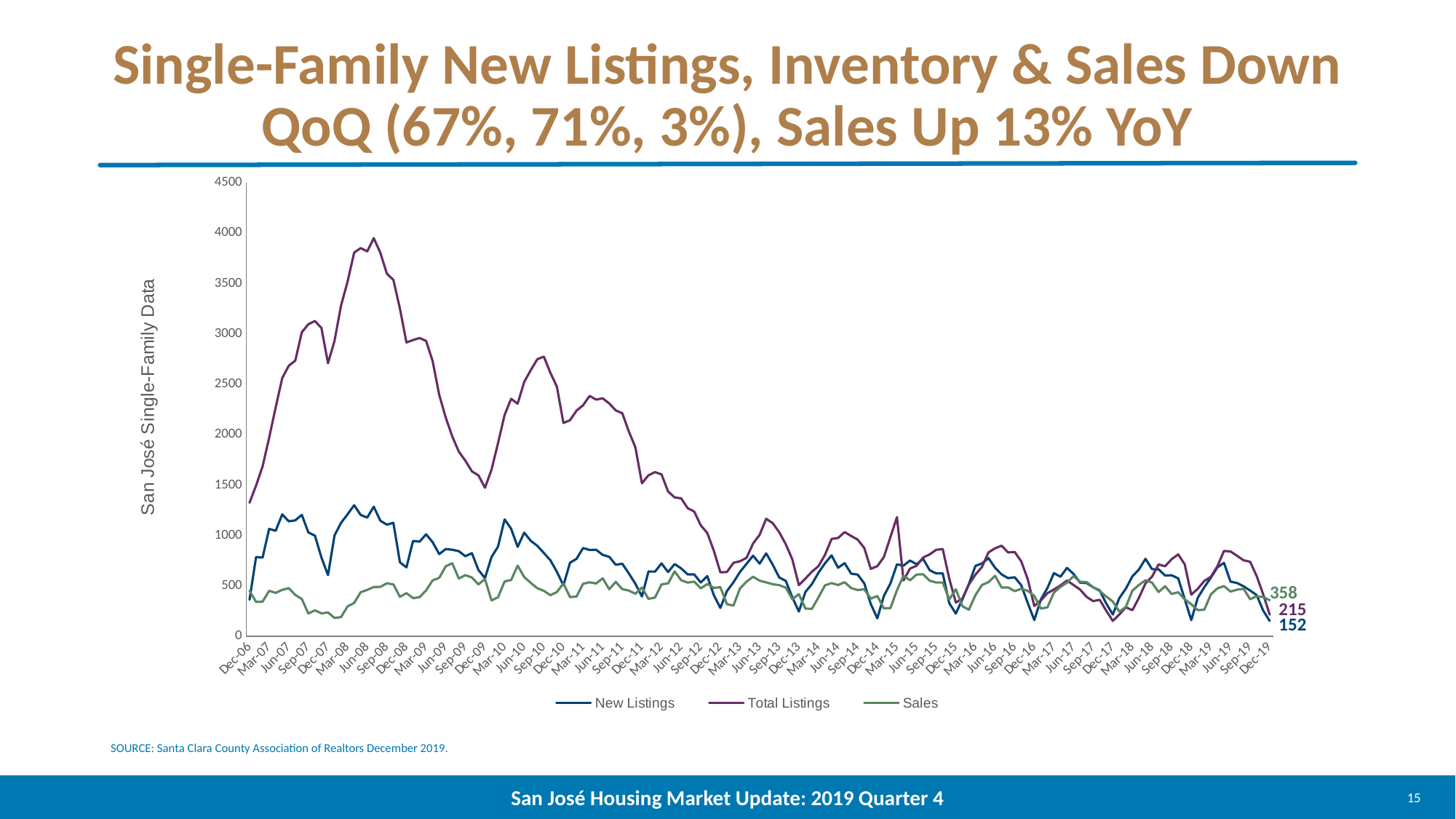
What is the title of the vertical axis? San José Single-Family Data At Dec-19, what is the difference between Sales and Total Listings? 143 What is the value of New Listings at Dec-19? 152 Is Total Listings at Dec-19 higher or lower than at Dec-06? lower What is the value of Total Listings at Dec-19? 215 What kind of chart is shown on the slide? line chart Is the peak value of Total Listings around Jun-08 greater or less than 3500? greater Which series has the highest value at Dec-19? Sales Which series has the lowest value at Dec-19? New Listings What is the value of Sales at Dec-19? 358 How many series does the chart's legend list? 3 At Dec-19, how much higher is Sales than New Listings? 206